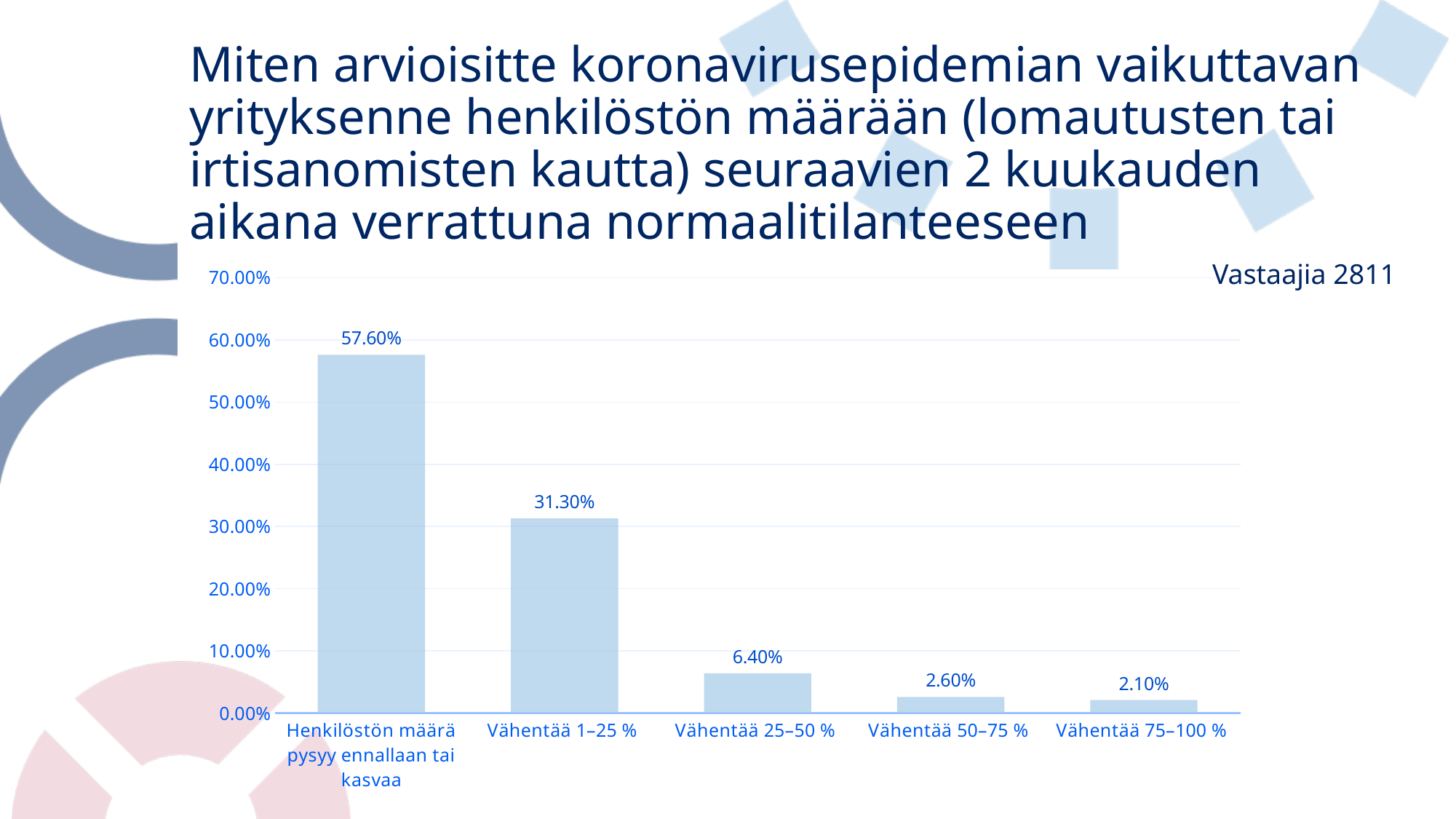
What is the value for "Vähentää 1–25 %"? 31.30% What kind of chart is shown on the slide? bar chart Which category has the highest value? Henkilöstön määrä pysyy ennallaan tai kasvaa What is the difference between the values for "Henkilöstön määrä pysyy ennallaan tai kasvaa" and "Vähentää 1–25 %"? 26.30% Which is larger, the value for "Vähentää 25–50 %" or "Vähentää 50–75 %"? Vähentää 25–50 % What is the value for "Vähentää 75–100 %"? 2.10% What is the value for "Vähentää 25–50 %"? 6.40% What is the value for "Henkilöstön määrä pysyy ennallaan tai kasvaa"? 57.60% How many categories are shown on the x axis? 5 Which category has the lowest value? Vähentää 75–100 % Is the value for "Vähentää 1–25 %" greater or less than 40.00%? less How many respondents (Vastaajia) does the slide report? 2811